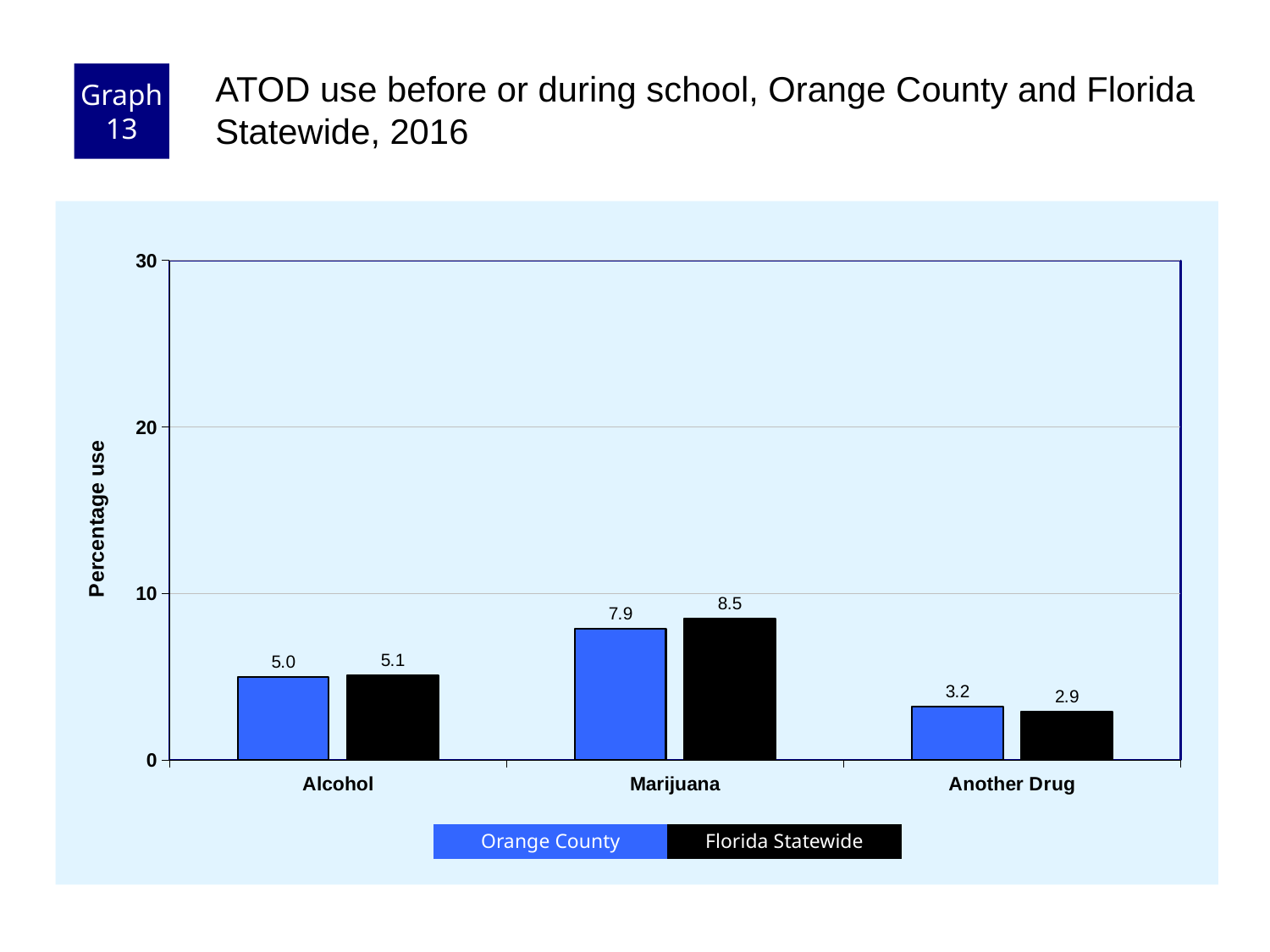
Which category has the lowest Orange County value? Another Drug What is the Orange County value for Marijuana? 7.9 How many series does the legend list? 2 What is the Florida Statewide value for Alcohol? 5.1 Which category has the highest Florida Statewide value? Marijuana Is the Florida Statewide value for Marijuana greater or less than 10? less What is the Orange County value for Another Drug? 3.2 What is the Florida Statewide value for Another Drug? 2.9 What is the difference between the Florida Statewide and Orange County values for Marijuana? 0.6 For Another Drug, which is larger: the Orange County value or the Florida Statewide value? Orange County What kind of chart is shown on the slide? bar chart How many categories are shown on the x axis? 3